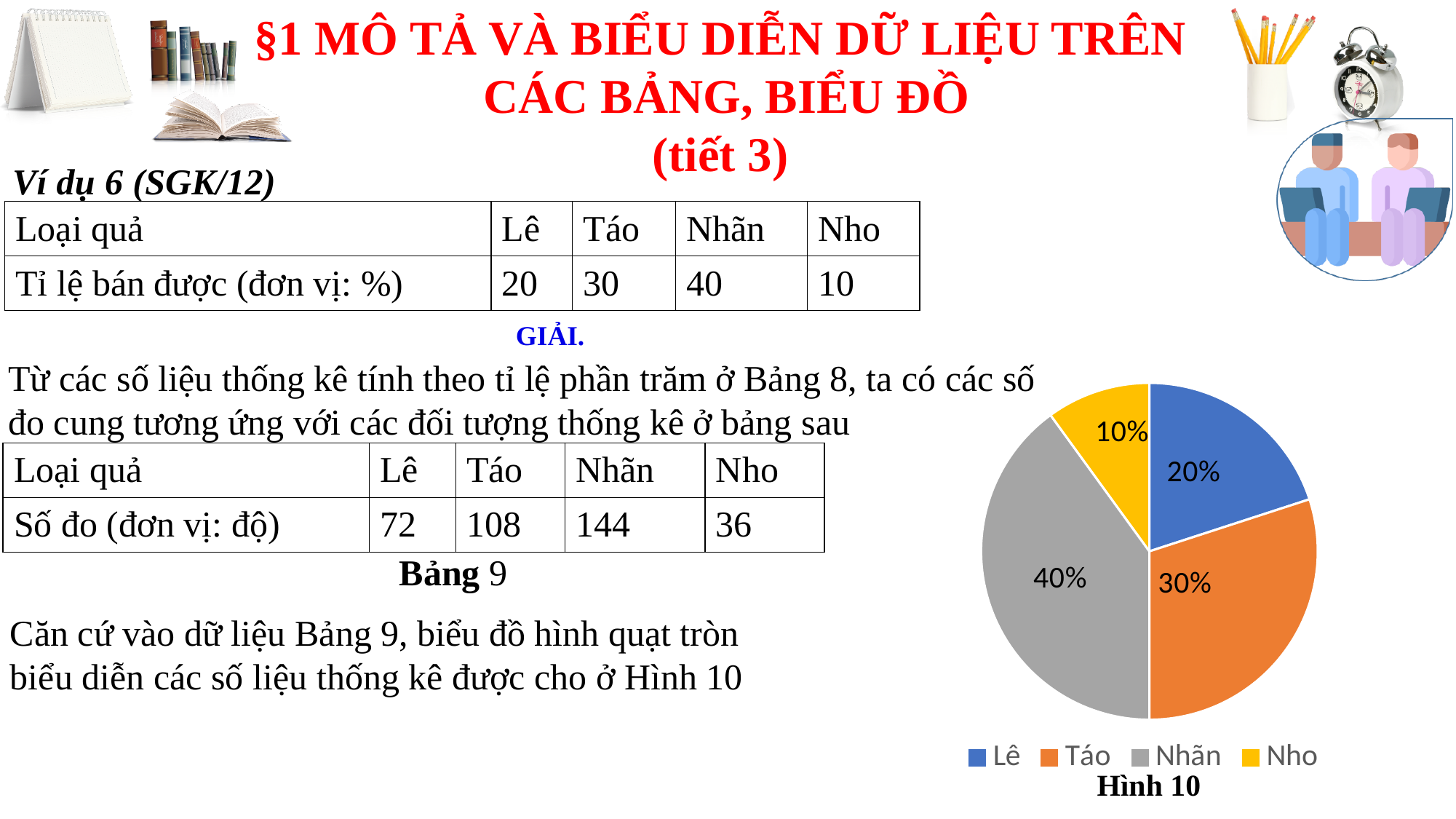
What kind of chart is shown in Hình 10? pie chart In the pie chart (Hình 10), what share does Nho have? 10% In the pie chart (Hình 10), what is the difference between the shares of Nhãn and Lê? 20% In the pie chart (Hình 10), which category has the largest slice? Nhãn In the pie chart (Hình 10), which is larger, the slice for Táo or the slice for Nho? Táo In the pie chart (Hình 10), what share does Nhãn have? 40% In the pie chart (Hình 10), what colour is the slice for Nhãn? grey In the pie chart (Hình 10), which category has the smallest slice? Nho In the pie chart (Hình 10), what share does Lê have? 20% In the pie chart (Hình 10), what share does Táo have? 30% How many entries does the legend of the pie chart in Hình 10 list? 4 How many slices does the pie chart in Hình 10 have? 4